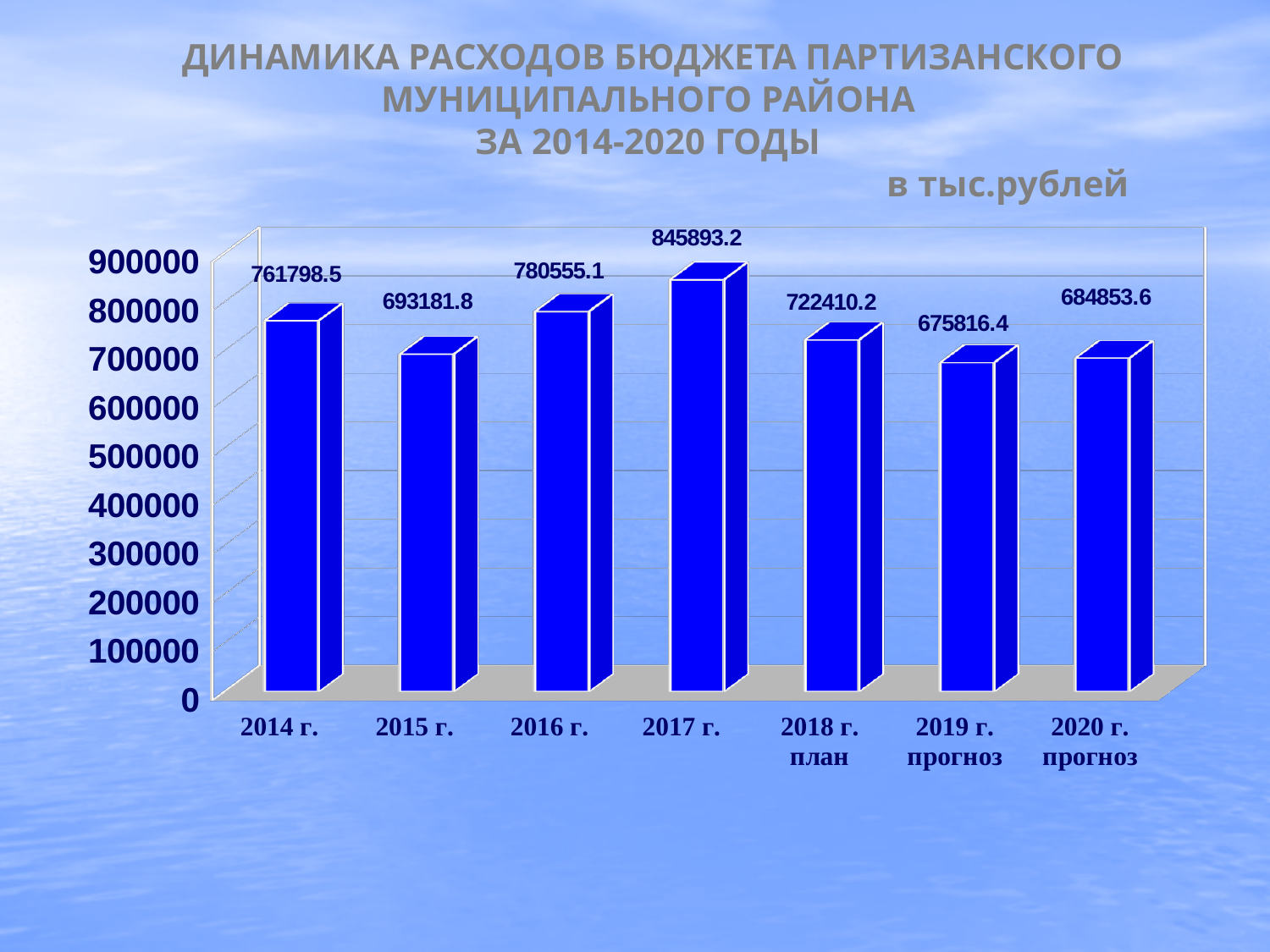
What is the difference between the values for 2014 г. and 2015 г.? 68616.7 What is the difference between the values for 2017 г. and 2019 г. прогноз? 170076.8 Which is larger, the value for 2016 г. or the value for 2018 г. план? 2016 г. Which year has the highest value? 2017 г. How many years (categories) are shown on the chart? 7 What is the value for 2020 г. прогноз? 684853.6 Which year has the lowest value? 2019 г. прогноз What is the value for 2014 г.? 761798.5 What kind of chart is shown on the slide? bar chart In what units are the values on the chart given, according to the slide? в тыс.рублей What is the value for 2018 г. план? 722410.2 Is the value for 2017 г. greater or less than 800000? greater